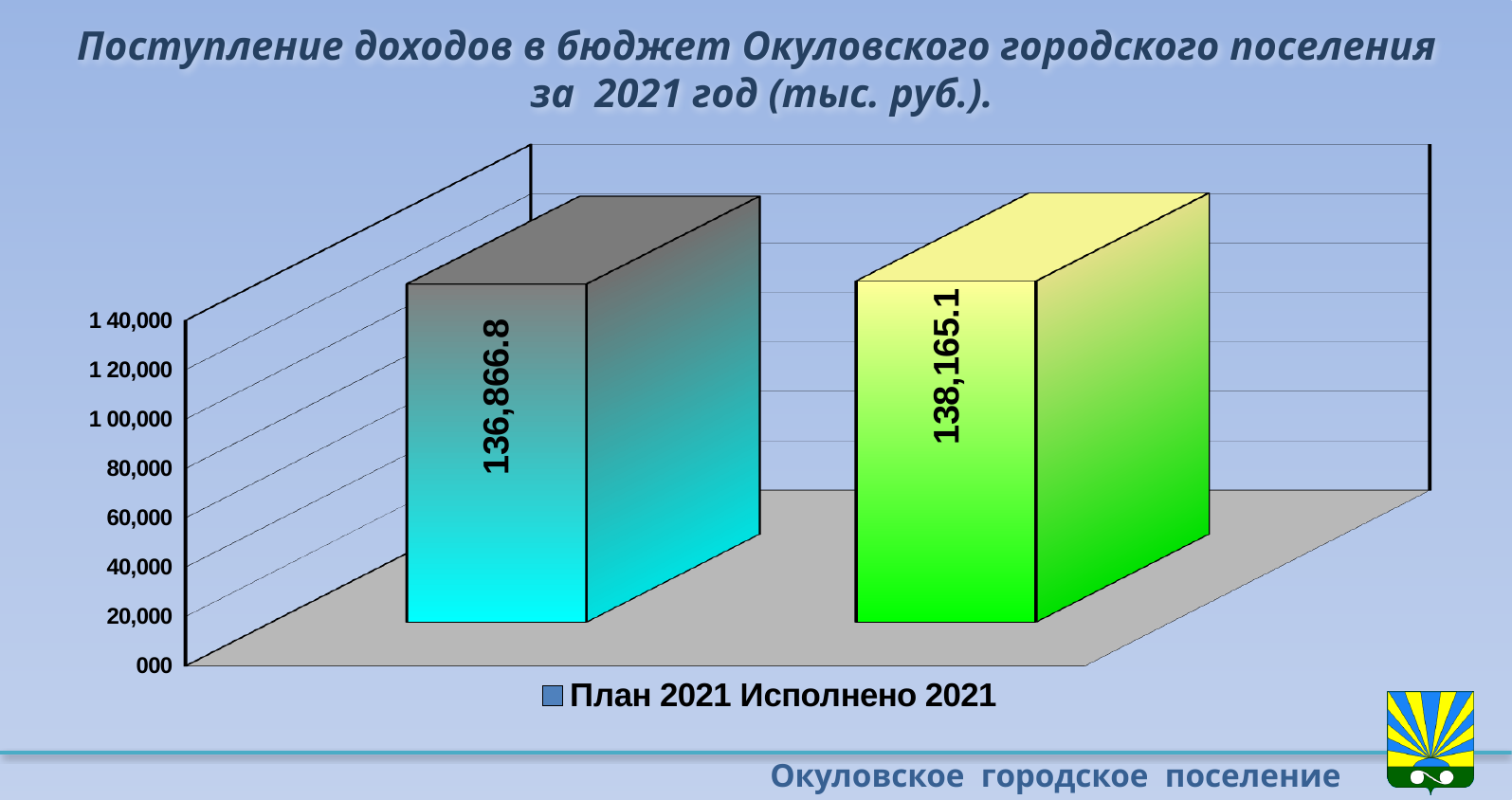
What is the value for План 2021? 136,866.8 How many bars are plotted in the chart? 2 What is the difference between Исполнено 2021 and План 2021? 1,298.3 Which bar has the higher value, План 2021 or Исполнено 2021? Исполнено 2021 In what units are the values on the chart given, according to the title? тыс. руб. Is the value for План 2021 larger or smaller than the value for Исполнено 2021? smaller Is the value for План 2021 greater or less than 120,000? greater What is the value for Исполнено 2021? 138,165.1 What kind of chart is shown on the slide? bar chart Is the value for Исполнено 2021 greater or less than 100,000? greater What is the title of the chart? Поступление доходов в бюджет Окуловского городского поселения за 2021 год (тыс. руб.) Which bar has the lower value? План 2021